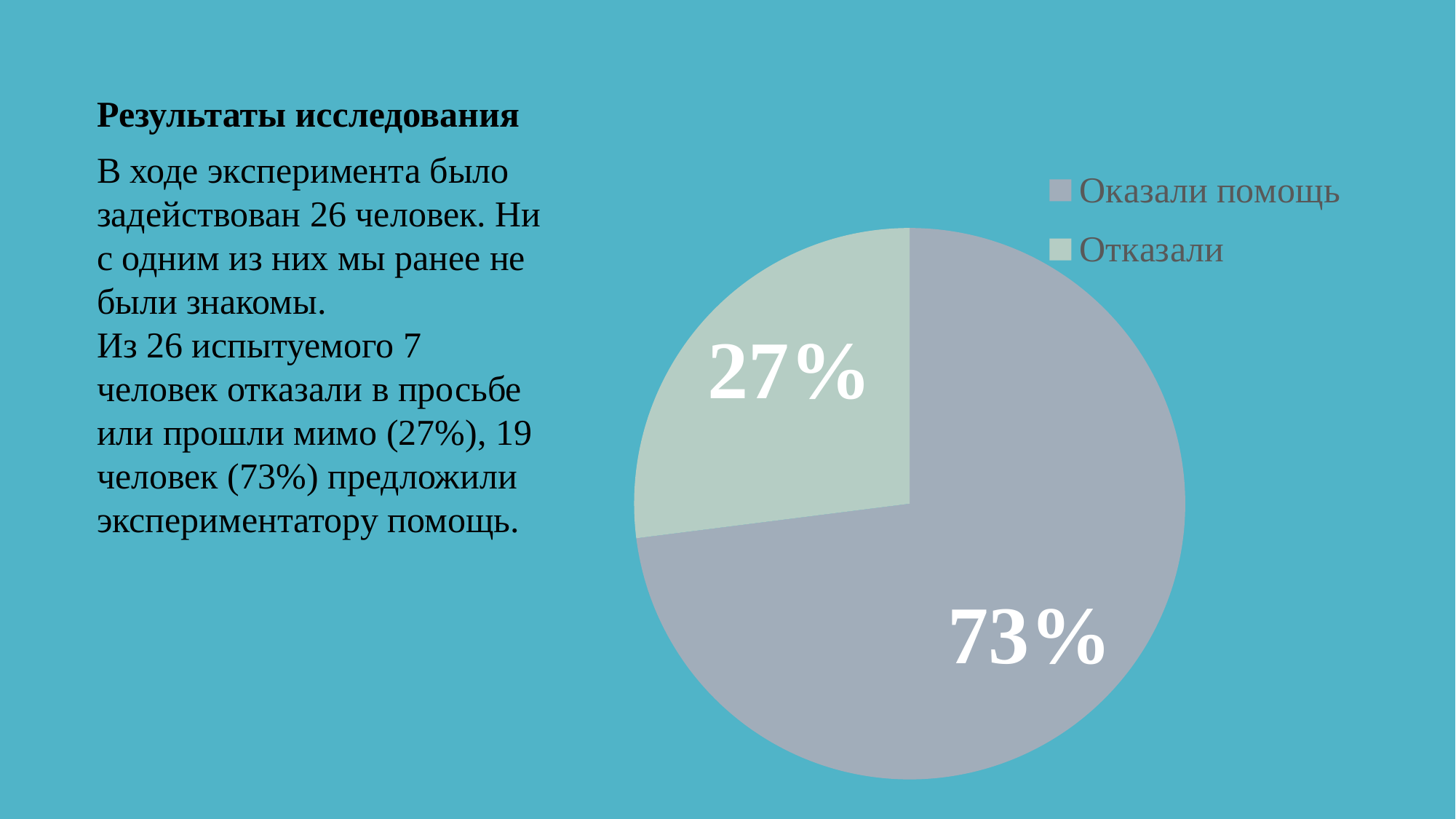
Which is larger: the 'Отказали' slice or the 'Оказали помощь' slice? Оказали помощь What percentage is shown for the 'Отказали' slice? 27% What kind of chart is shown on the slide? pie chart Which slice of the pie chart is the largest? Оказали помощь What share of the pie does the 'Отказали' slice represent? 27% How many entries does the legend list? 2 Which legend entry is shown with the light green colour? Отказали What percentage is shown for the 'Оказали помощь' slice? 73% How many slices does the pie chart have? 2 Which slice of the pie chart is the smallest? Отказали Which legend entry is shown with the grey colour? Оказали помощь What is the difference in percentage points between the 'Оказали помощь' and 'Отказали' slices? 46